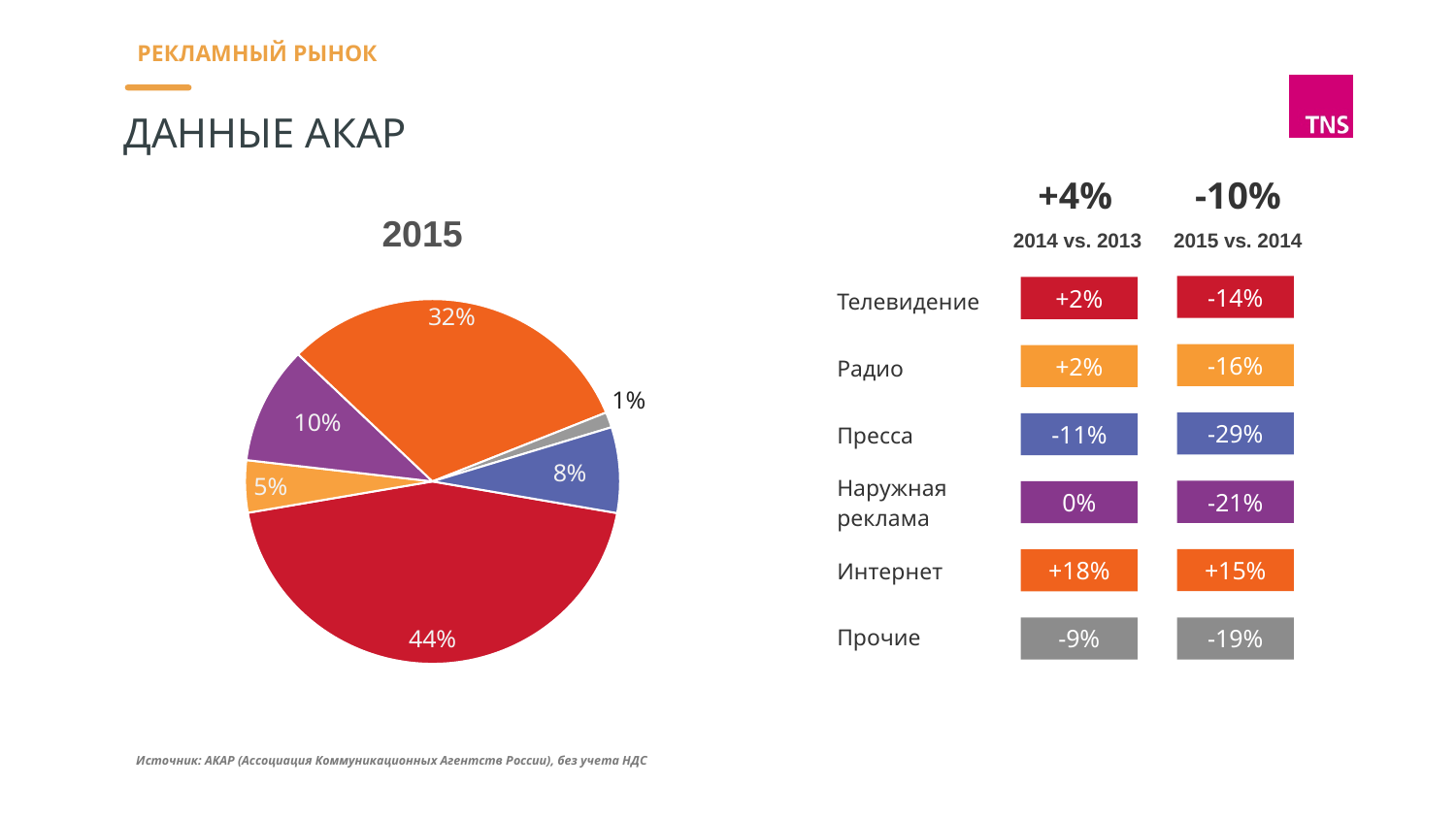
What share does the red slice of the pie chart represent? 44% What is the value of the smallest slice in the pie chart? 1% What is the value of the largest slice in the pie chart? 44% What do the red and orange slices of the pie chart add up to? 76% How many slices does the pie chart have? 6 What is the title of the pie chart? 2015 What is the difference between the largest slice (44%) and the second largest slice (32%) in the pie chart? 12 percentage points What share does the orange slice of the pie chart represent? 32% What share does the blue slice of the pie chart represent? 8% What kind of chart is shown on the slide? Pie chart What share does the purple slice of the pie chart represent? 10% Which slice is larger in the pie chart, the purple one or the blue one? The purple one (10%)